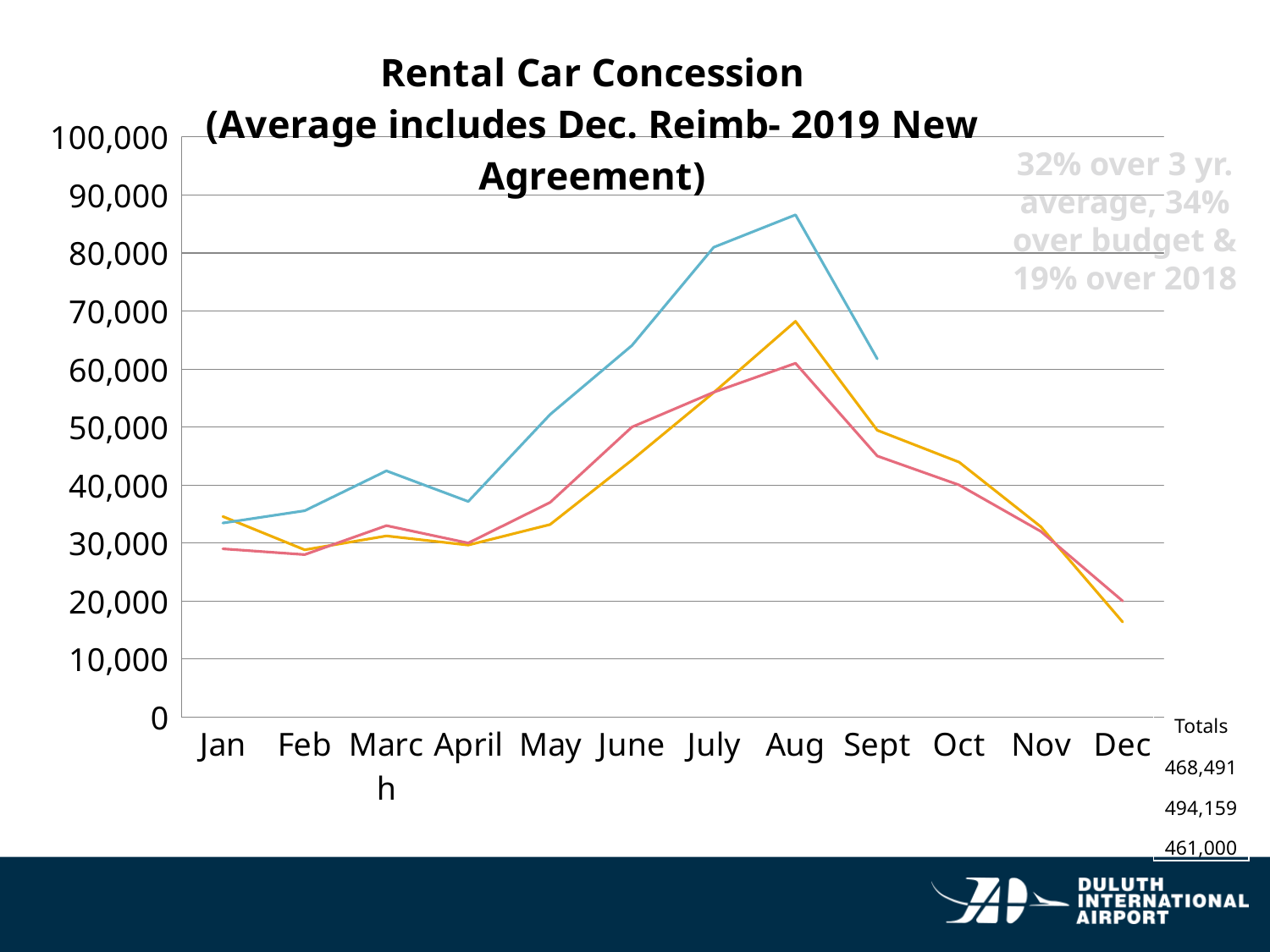
Is the value of the blue line in Aug greater or less than 80,000? greater How many months are shown along the x axis of the chart? 12 Does the orange line rise or fall from Aug to Dec? fall Does the blue line rise or fall from April to Aug? rise How many lines are plotted on the chart? 3 Is the value of the orange line in Dec greater or less than 20,000? less In June, which line is higher, the pink line or the orange line? the pink line What kind of chart is shown on the slide? line chart Is the value of the pink line in Aug greater or less than 50,000? greater In which month does the blue line reach its highest value? Aug In Aug, which line is higher, the blue line or the pink line? the blue line In which month does the orange line reach its highest value? Aug